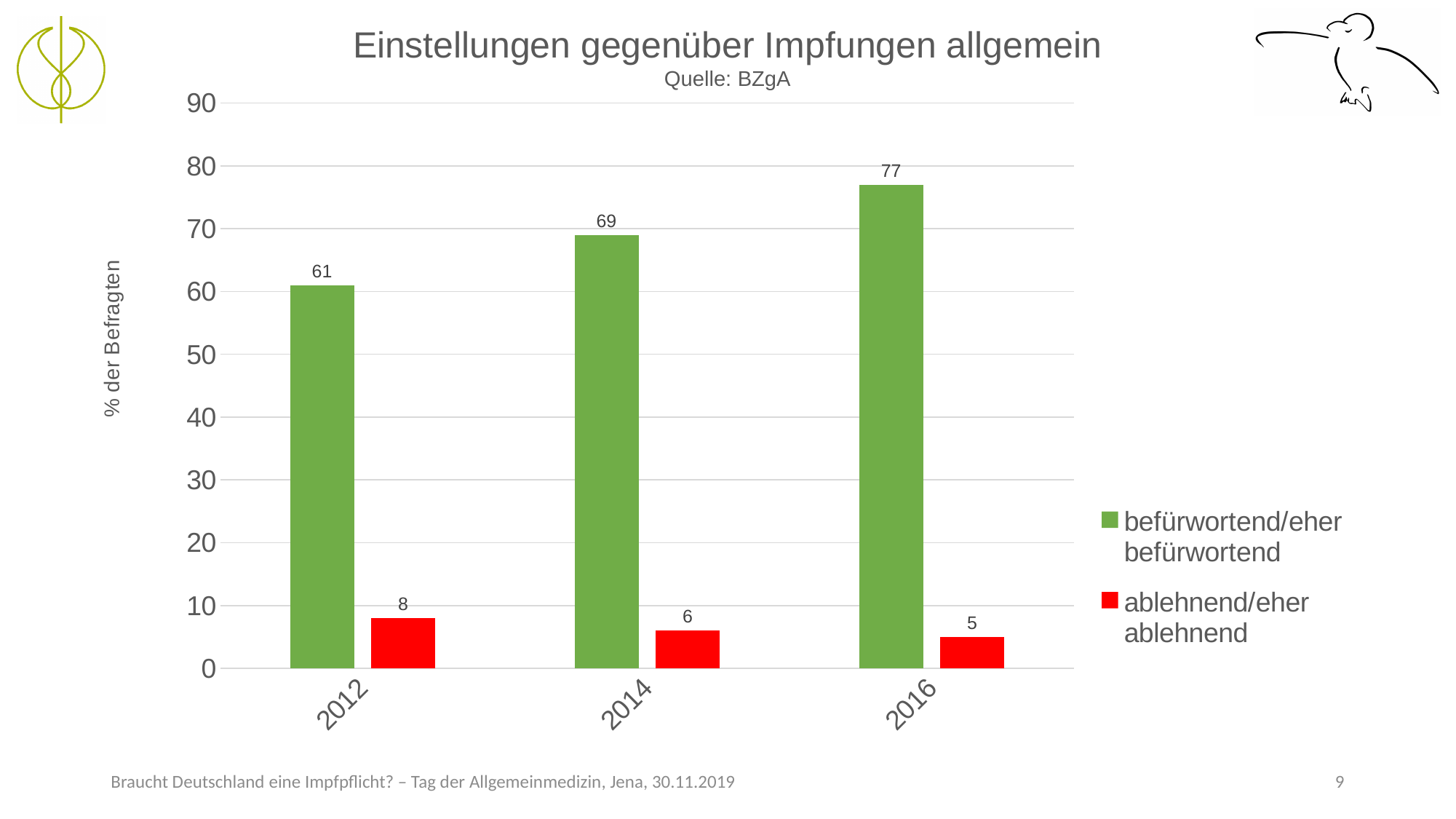
What is the value for "ablehnend/eher ablehnend" in 2012? 8 How many years are shown on the x axis? 3 Is the value for "befürwortend/eher befürwortend" in 2012 greater or less than 50? greater What is the difference between the "befürwortend/eher befürwortend" values in 2016 and 2012? 16 What is the value for "befürwortend/eher befürwortend" in 2016? 77 Does the "befürwortend/eher befürwortend" series rise or fall from 2012 to 2016? rise In which year is the "befürwortend/eher befürwortend" value highest? 2016 What kind of chart is shown on the slide? bar chart Which is larger: the "ablehnend/eher ablehnend" value in 2012 or in 2014? 2012 How many series does the legend list? 2 What is the value for "befürwortend/eher befürwortend" in 2014? 69 In which year is the "ablehnend/eher ablehnend" value lowest? 2016